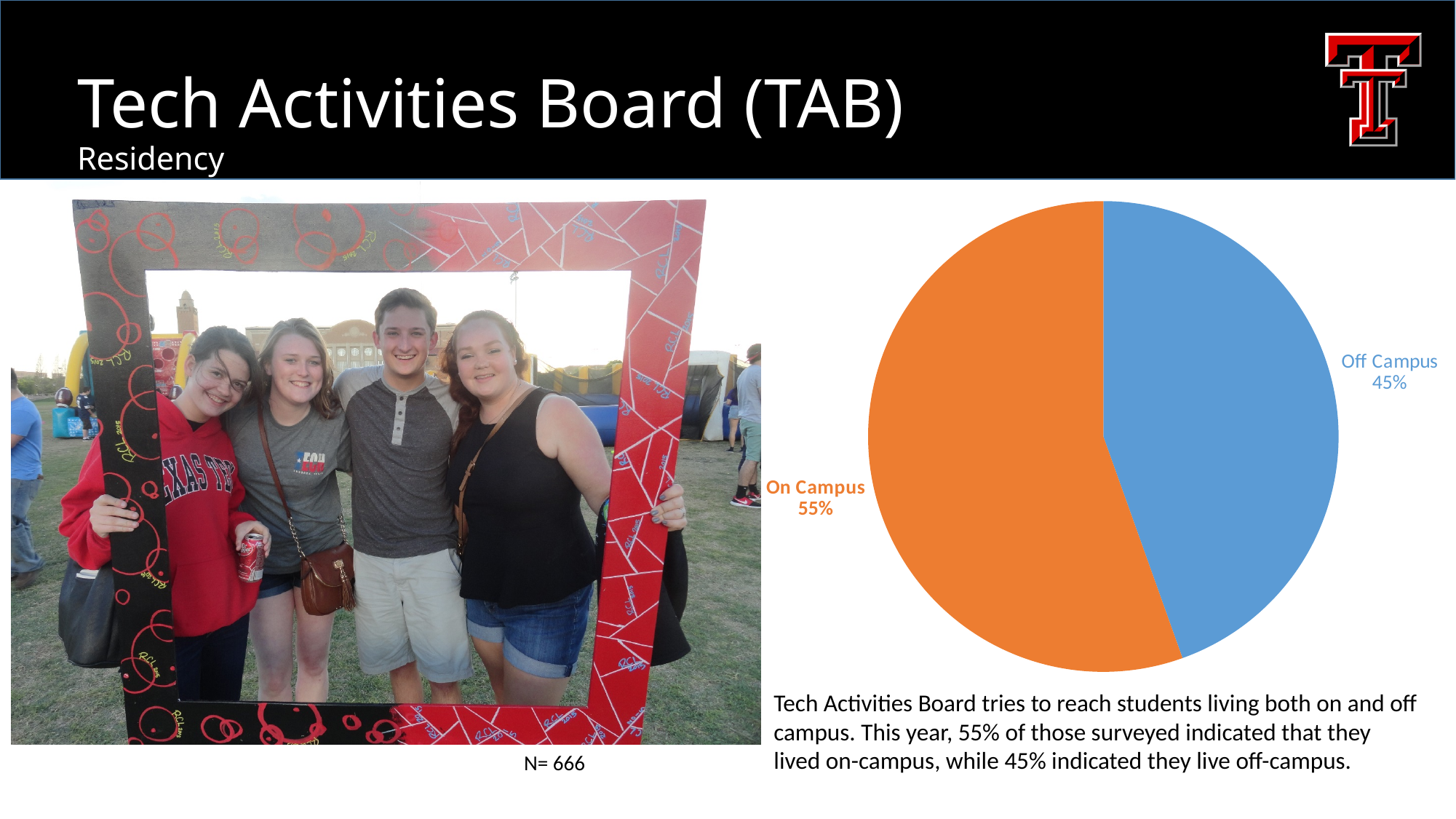
What is the difference in percentage points between the On Campus and Off Campus slices? 10 Which residency category has the smallest share in the pie chart? Off Campus Which slice is larger, On Campus or Off Campus? On Campus What share of the pie does the Off Campus slice represent? 45% What colour is the On Campus slice in the pie chart? Orange What type of chart is shown on the slide? Pie chart Which residency category has the largest share in the pie chart? On Campus What percentage of surveyed students live on campus according to the pie chart? 55% How many slices does the pie chart have? 2 Is the On Campus share greater or less than 50%? greater What colour is the Off Campus slice in the pie chart? Blue What percentage of surveyed students live off campus according to the pie chart? 45%